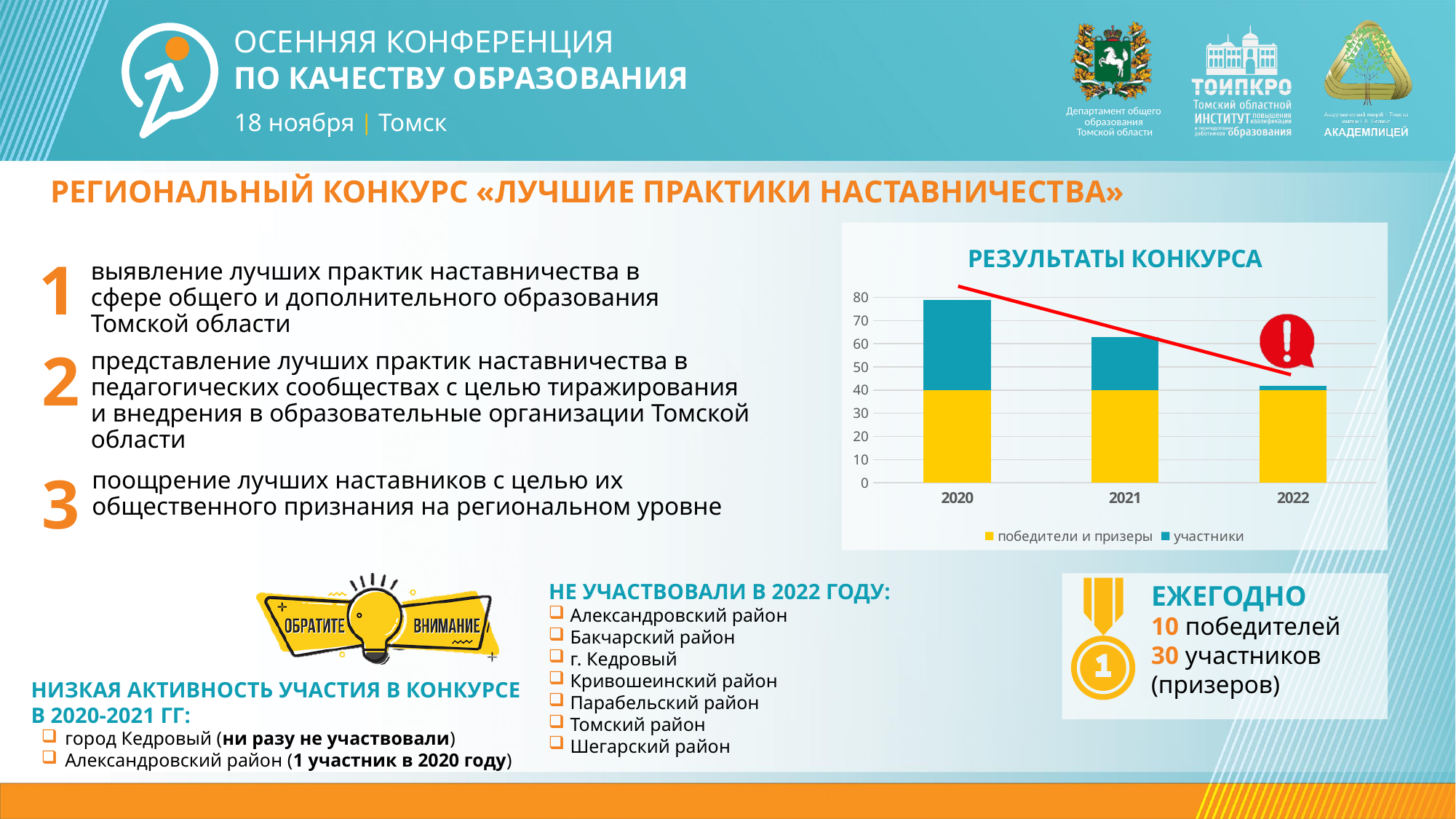
In the «РЕЗУЛЬТАТЫ КОНКУРСА» chart, is the total bar height for 2020 greater or less than 70? greater In the «РЕЗУЛЬТАТЫ КОНКУРСА» chart, what value does the «победители и призеры» segment reach in 2020? 40 Which series is shown in yellow in the «РЕЗУЛЬТАТЫ КОНКУРСА» chart? победители и призеры In the «РЕЗУЛЬТАТЫ КОНКУРСА» chart, is the «участники» segment larger in 2020 or in 2021? 2020 How many years are shown on the x axis of the «РЕЗУЛЬТАТЫ КОНКУРСА» chart? 3 Do the total bar heights in the «РЕЗУЛЬТАТЫ КОНКУРСА» chart rise or fall from 2020 to 2022? Fall In the «РЕЗУЛЬТАТЫ КОНКУРСА» chart, is the total bar height for 2022 greater or less than 50? less What kind of chart is shown under the title «РЕЗУЛЬТАТЫ КОНКУРСА»? Stacked bar chart In the «РЕЗУЛЬТАТЫ КОНКУРСА» chart, is the total bar height for 2021 greater or less than 70? less How many series does the legend of the «РЕЗУЛЬТАТЫ КОНКУРСА» chart list? 2 Which year has the shortest bar in the «РЕЗУЛЬТАТЫ КОНКУРСА» chart? 2022 Which year has the tallest bar in the «РЕЗУЛЬТАТЫ КОНКУРСА» chart? 2020